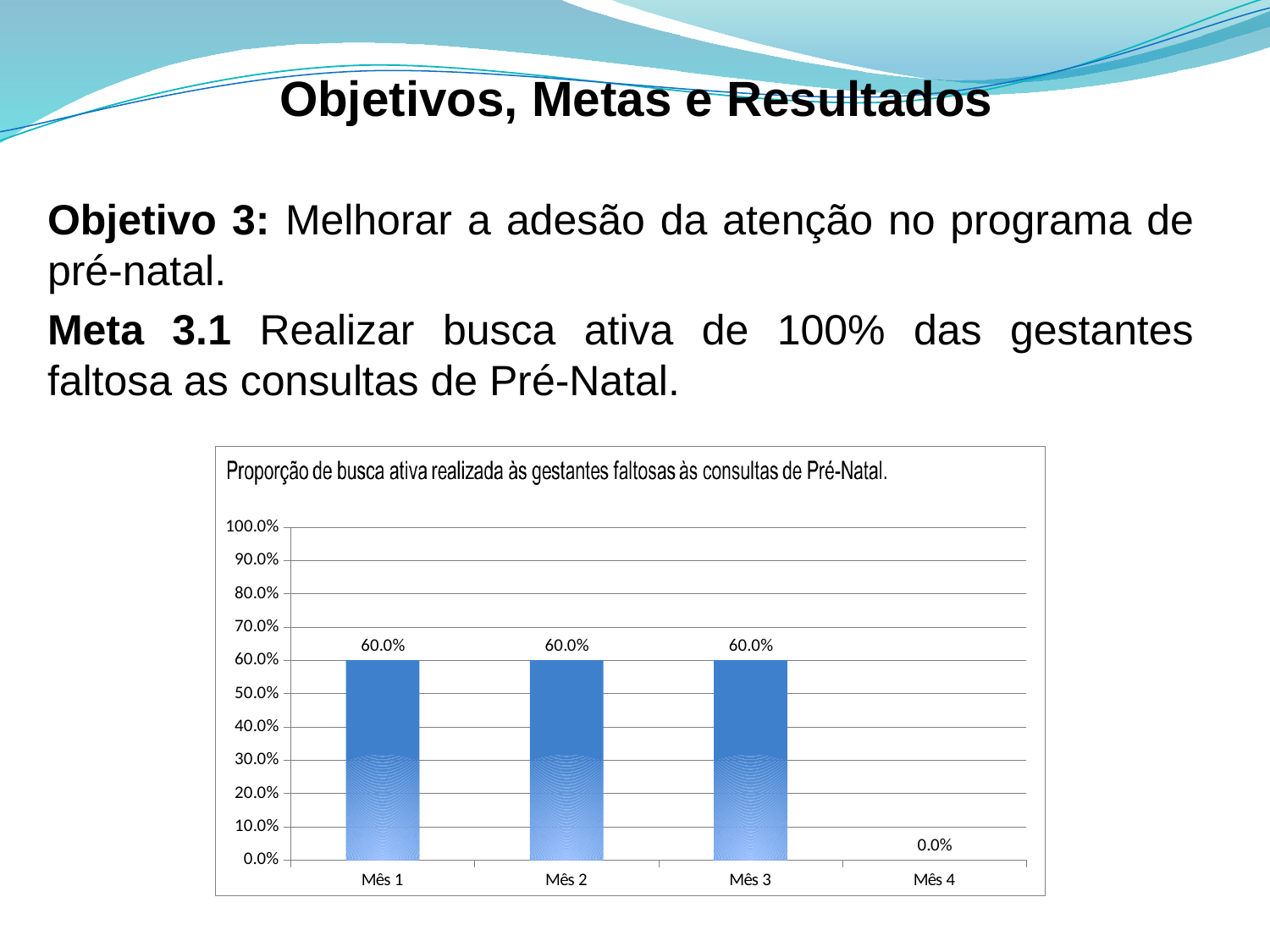
Do the values rise, fall or stay the same from Mês 1 to Mês 3? stay the same Which month has the lowest value? Mês 4 Is the value for Mês 2 greater or less than 70.0%? less Which is larger, the value for Mês 3 or the value for Mês 4? Mês 3 Is the value for Mês 1 greater or less than 50.0%? greater What is the title of the chart? Proporção de busca ativa realizada às gestantes faltosas às consultas de Pré-Natal. What is the value for Mês 3? 60.0% What is the value for Mês 4? 0.0% What is the difference between the values for Mês 2 and Mês 4? 60.0% How many months are shown on the x axis? 4 What is the value for Mês 1? 60.0% What kind of chart is shown? bar chart